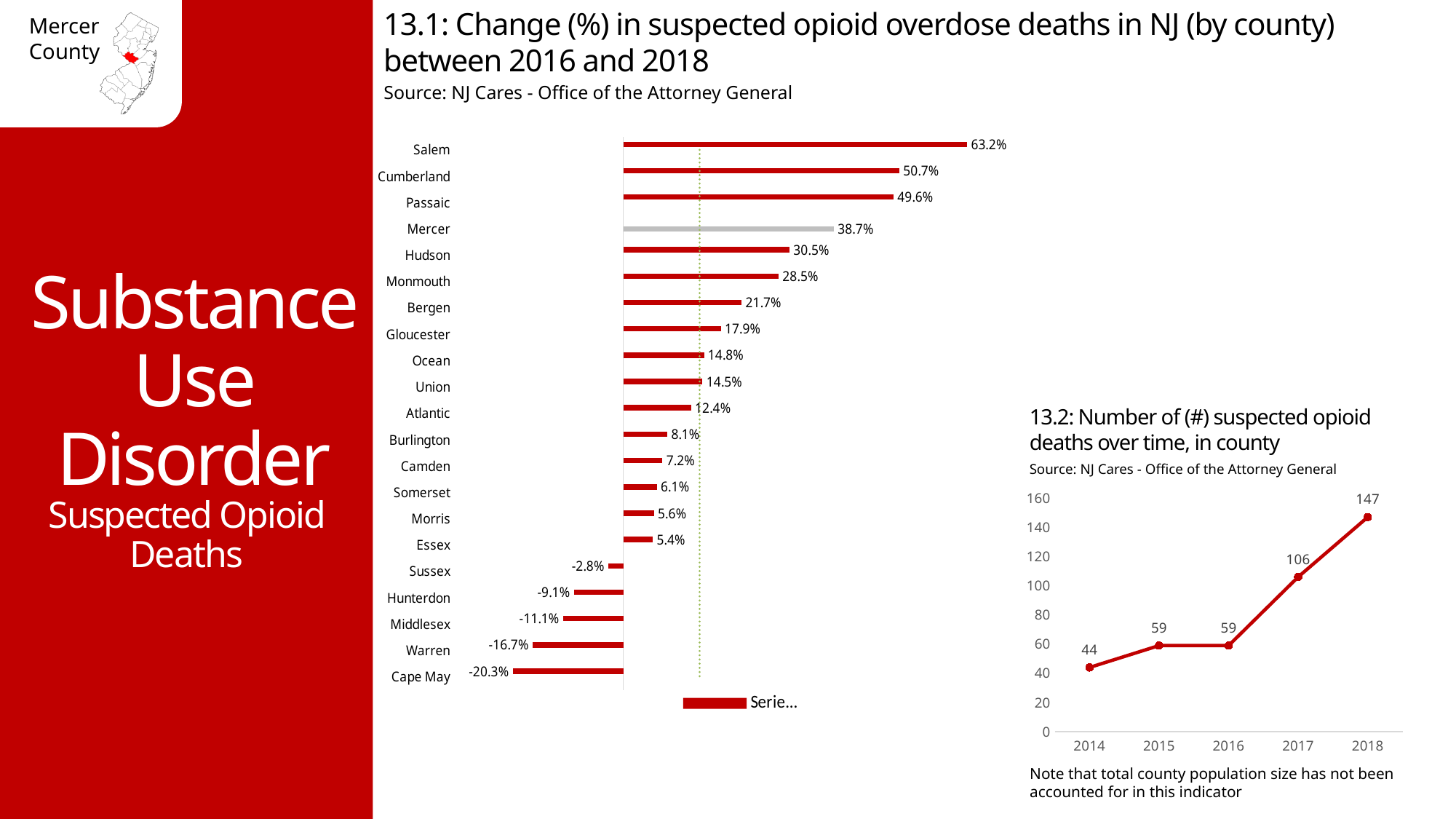
In chart 13.2, what is the difference between the values for 2018 and 2017? 41 In chart 13.1, which county's bar is shown in grey rather than red? Mercer In chart 13.1, what is the value for Hudson? 30.5% In chart 13.2, do the values rise or fall from 2014 to 2018? Rise In chart 13.2 (Number of suspected opioid deaths over time, in county), what is the value for 2018? 147 In chart 13.1, what is the difference between the values for Salem and Cumberland? 12.5% What kind of chart is chart 13.1? Bar chart In chart 13.1, which county has the highest change in suspected opioid overdose deaths? Salem In chart 13.1 (Change (%) in suspected opioid overdose deaths in NJ by county), what is the value for Mercer? 38.7% In chart 13.1, which county has the larger value, Bergen or Gloucester? Bergen In chart 13.1, how many counties are shown? 21 In chart 13.1, which county has the lowest change in suspected opioid overdose deaths? Cape May